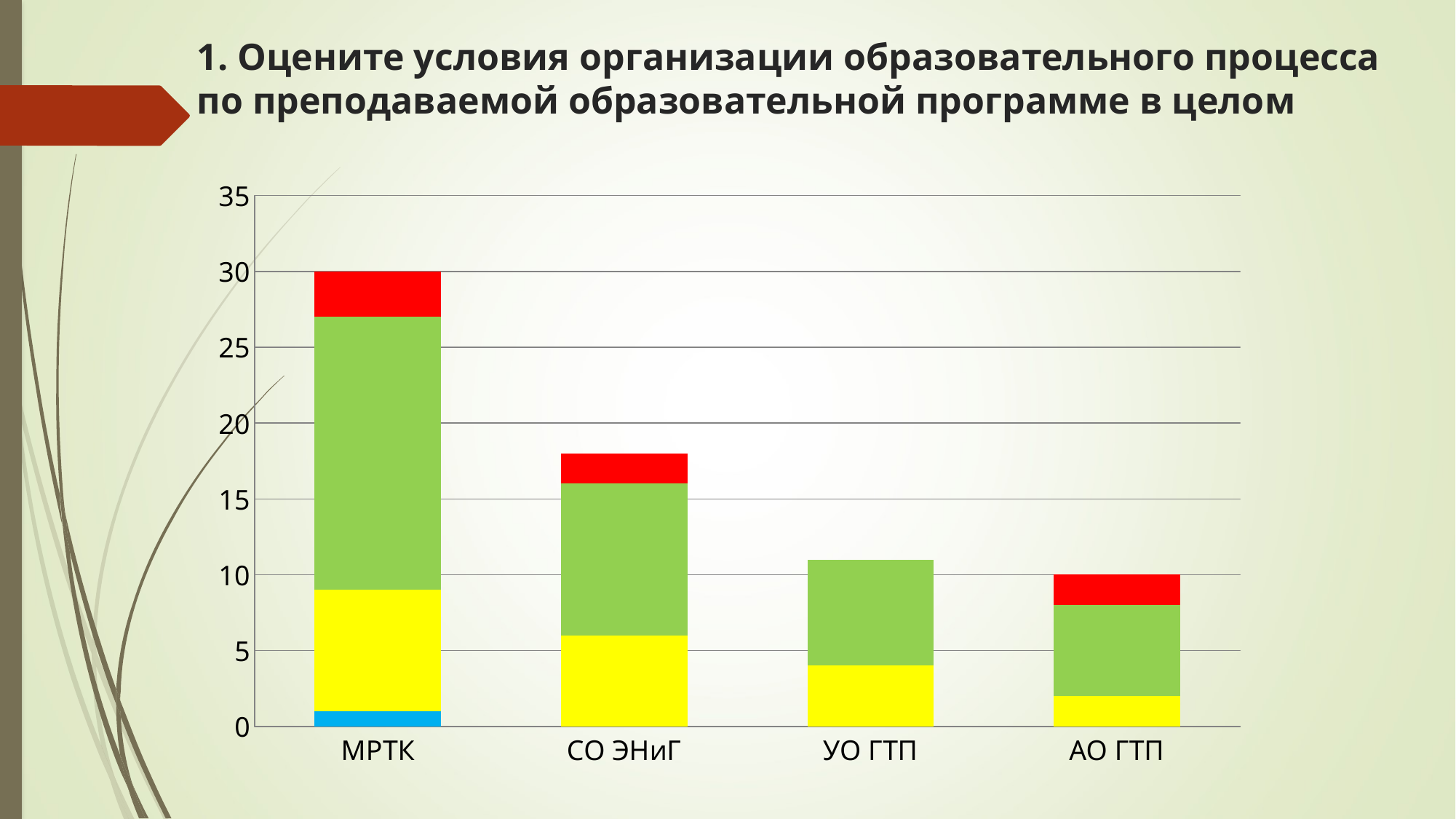
What is the total height of the stacked bar for МРТК? 30 Which category has the shortest stacked bar? АО ГТП Which category has the tallest stacked bar? МРТК What is the total height of the stacked bar for АО ГТП? 10 Do the total bar heights rise or fall from left to right along the x axis? fall Is the total value for СО ЭНиГ greater or less than 20? less What kind of chart is shown on the slide? stacked bar chart How many categories are shown on the x axis of the chart? 4 Which category's bar is the only one that includes a blue segment? МРТК Is the total value for УО ГТП greater or less than 15? less Is the total value for СО ЭНиГ greater or less than 15? greater Which stacked bar is taller, МРТК or СО ЭНиГ? МРТК